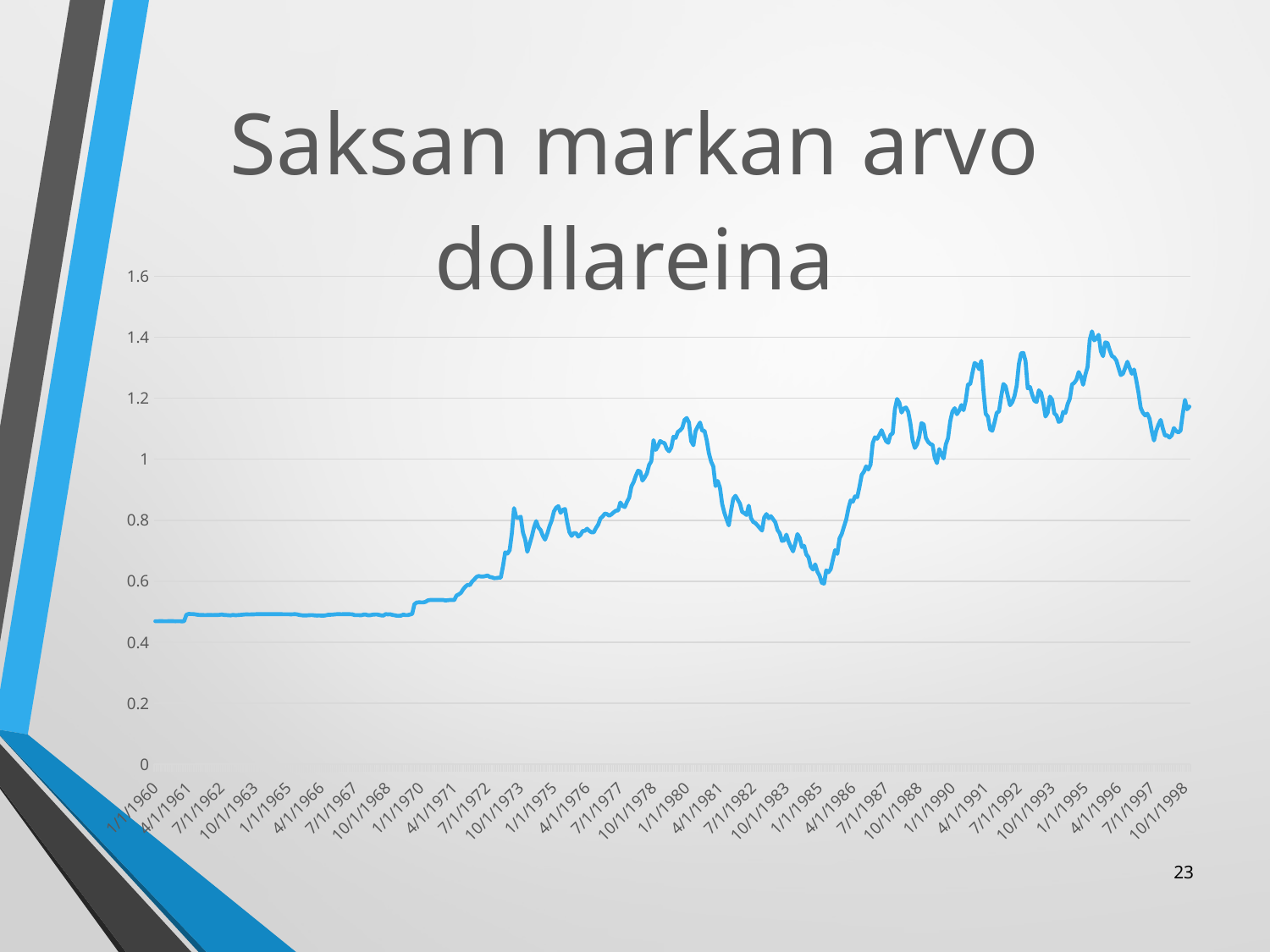
Is the value at 10/1/1998 greater or less than 1? greater Overall, does the line rise or fall from 1/1/1960 to 10/1/1998? rise Is the value at 1/1/1980 greater or less than 1? greater Is the value at 1/1/1995 larger or smaller than the value at 1/1/1985? larger What is the title of the chart? Saksan markan arvo dollareina How many data series are plotted in the chart? 1 What kind of chart is shown on the slide? line chart Is the value at 1/1/1985 greater or less than 0.8? less Does the line rise or fall between 1/1/1980 and 1/1/1985? fall